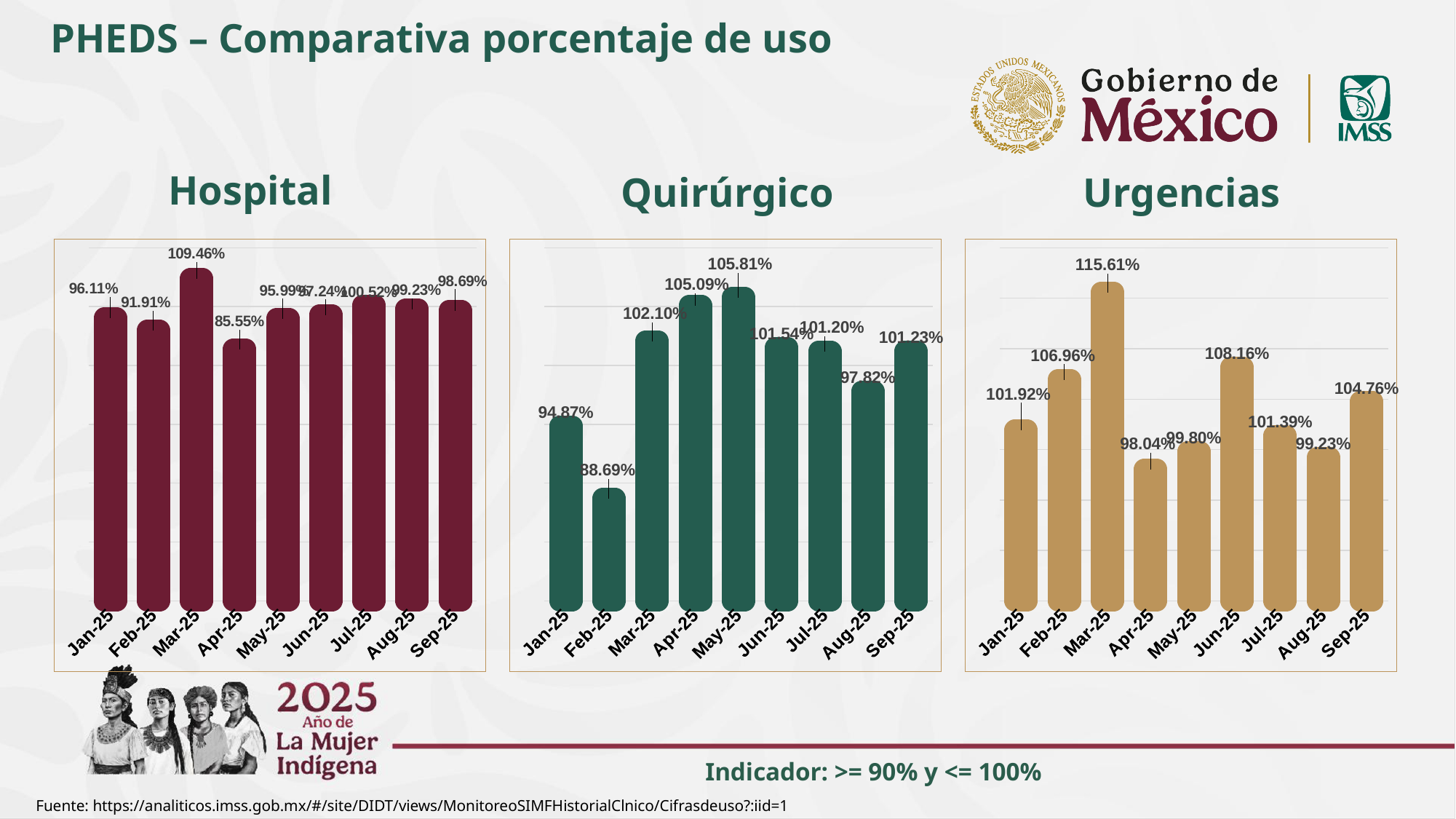
In the Quirúrgico chart, which is larger, the value for Jan-25 or the value for Aug-25? Aug-25 In the Quirúrgico chart, which month has the lowest value? Feb-25 In the Hospital chart, which month has the lowest value? Apr-25 In the Hospital chart, what is the difference between the Mar-25 and Apr-25 values? 23.91% How many months are shown in the Urgencias chart? 9 In the Urgencias chart, what is the difference between the Jun-25 and Jul-25 values? 6.77% What is the title of the chart on the right of the slide? Urgencias What type of chart is the Hospital chart? Bar chart In the Urgencias chart, what is the value for Mar-25? 115.61% In the Hospital chart, what is the value for Mar-25? 109.46% In the Urgencias chart, which month has the highest value? Mar-25 In the Quirúrgico chart, what is the value for May-25? 105.81%